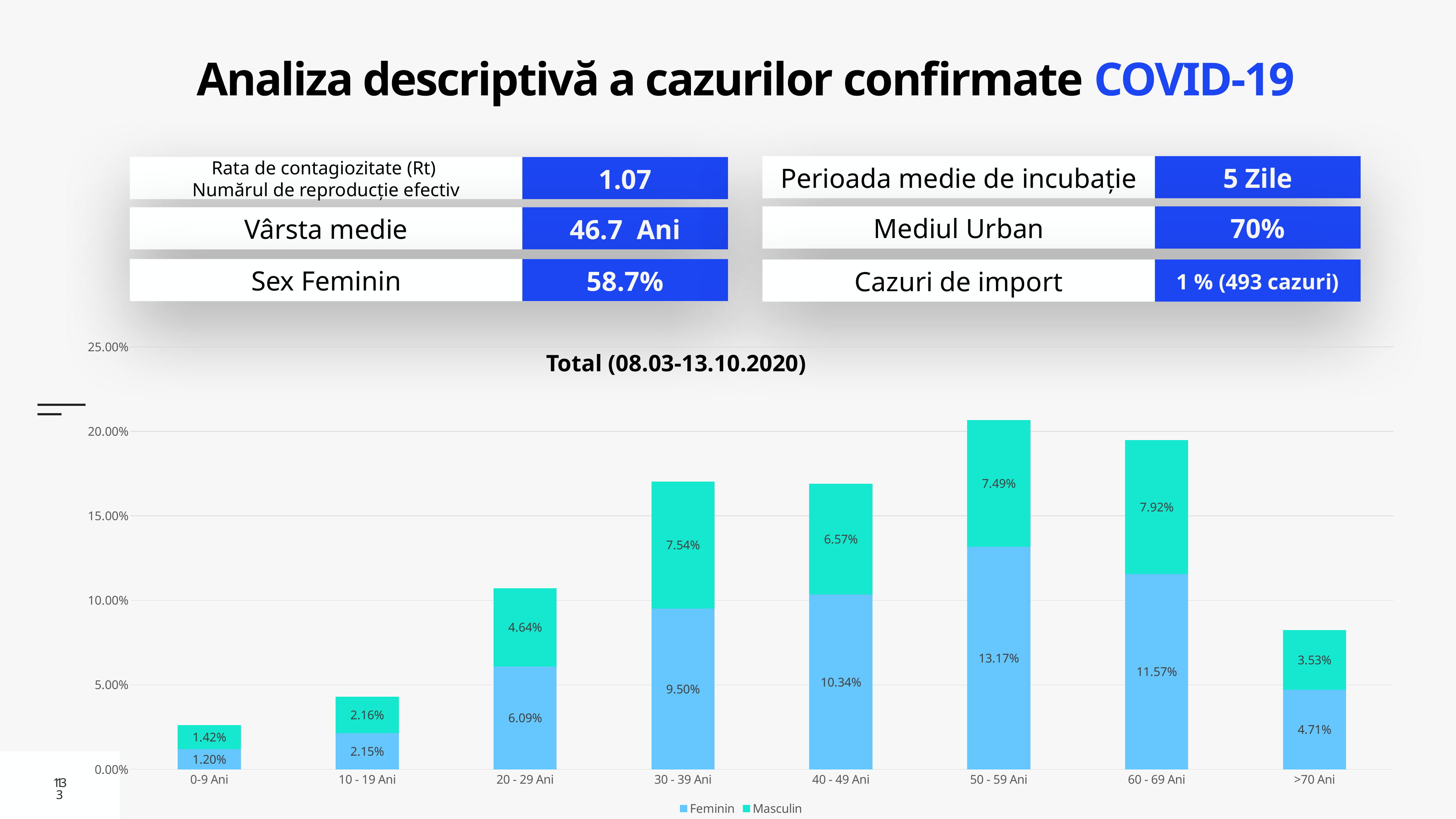
Which age group has the highest Feminin value? 50 - 59 Ani What is the difference between the Feminin and Masculin values for the 40 - 49 Ani age group? 3.77% What is the Masculin value for the 30 - 39 Ani age group? 7.54% What is the Feminin value for the >70 Ani age group? 4.71% How many age groups are shown on the x axis of the chart? 8 What is the title of the chart? Total (08.03-13.10.2020) What kind of chart is shown on the slide? Stacked bar chart How many series does the chart legend list? 2 What is the total of the stacked bar for the 60 - 69 Ani age group? 19.49% Which age group has the lowest Masculin value? 0-9 Ani Which is larger for the 20 - 29 Ani age group, the Feminin value or the Masculin value? Feminin What is the Feminin value for the 50 - 59 Ani age group? 13.17%